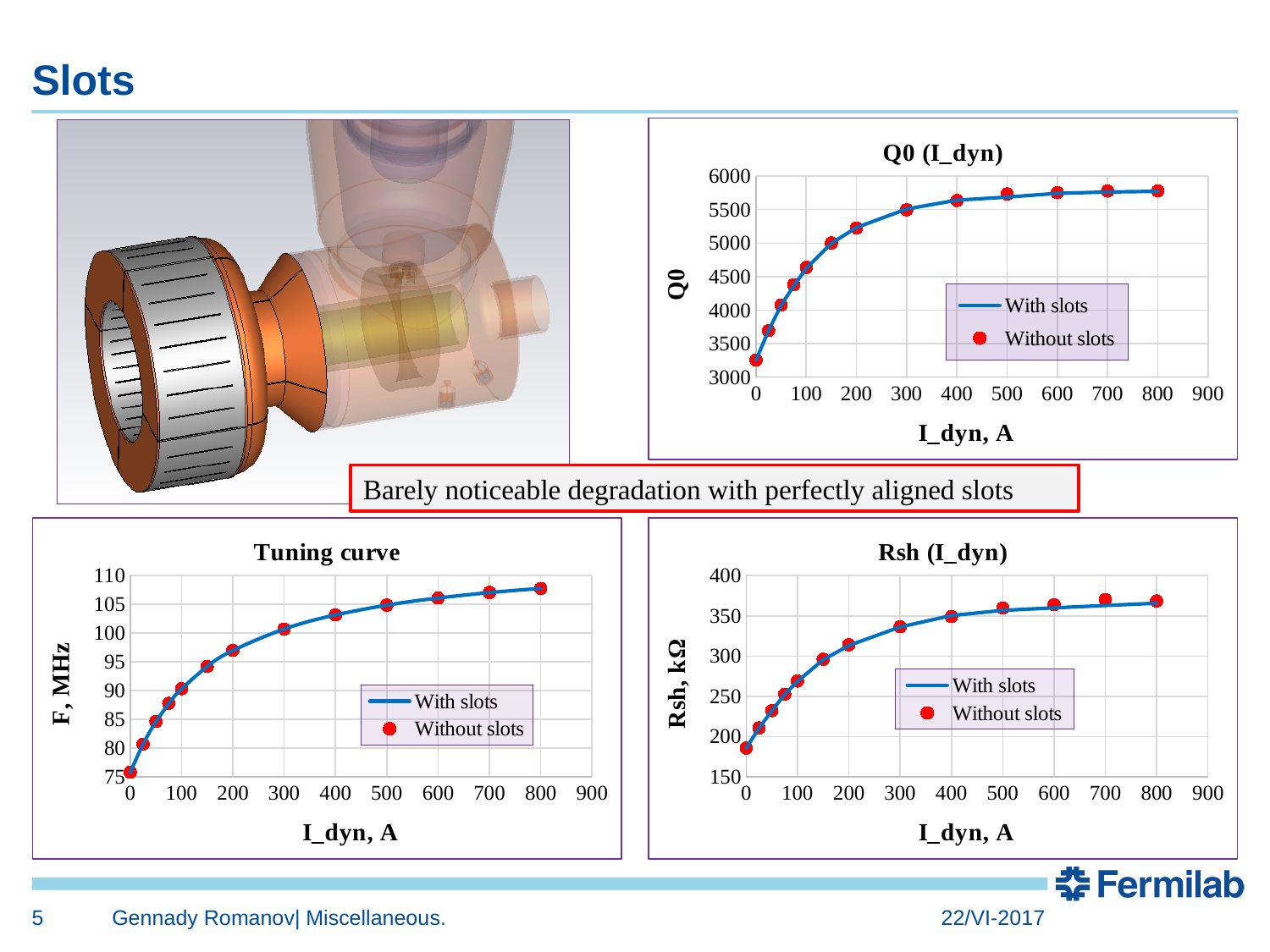
What are the two legend entries in the "Rsh (I_dyn)" chart? With slots, Without slots In the "Q0 (I_dyn)" chart, is the Q0 value at I_dyn = 800 A greater or less than 5500? greater In the "Q0 (I_dyn)" chart, do the Q0 values rise or fall as I_dyn increases? rise What kind of chart is the "Q0 (I_dyn)" chart? line chart with scatter points In the "Tuning curve" chart, is the F value at I_dyn = 800 A greater or less than 105 MHz? greater In the "Rsh (I_dyn)" chart, is the Rsh value at I_dyn = 0 A greater or less than 200 kΩ? less How many series does the legend of the "Tuning curve" chart list? 2 In the "Tuning curve" chart, does F rise or fall as I_dyn increases? rise In the "Rsh (I_dyn)" chart, does Rsh rise or fall as I_dyn increases? rise